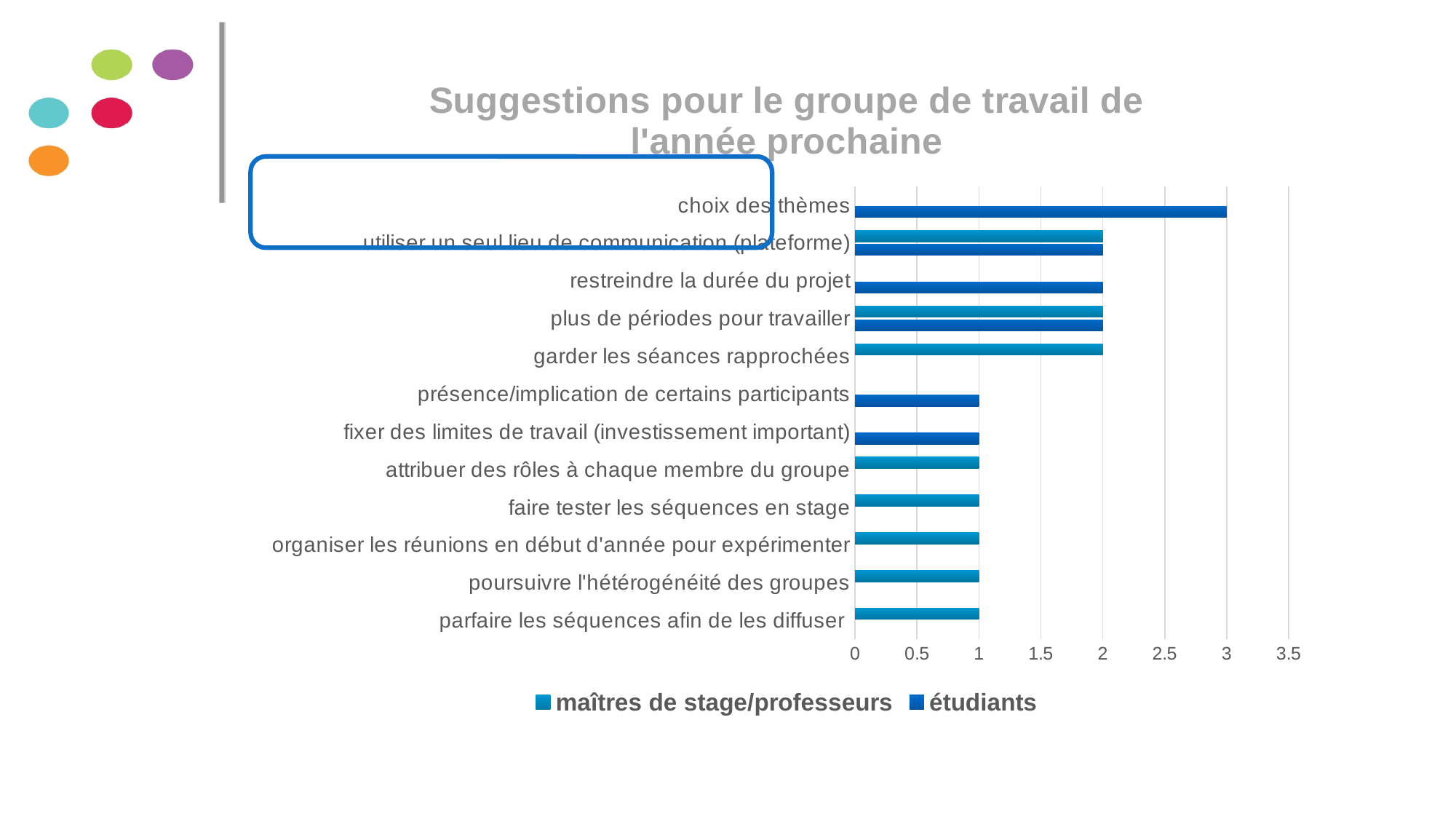
What is the value for 'garder les séances rapprochées' in the 'maîtres de stage/professeurs' series? 2 How many categories are plotted on the chart? 12 What is the difference between the 'étudiants' value for 'choix des thèmes' and the 'étudiants' value for 'fixer des limites de travail (investissement important)'? 2 What is the value for 'restreindre la durée du projet' in the 'étudiants' series? 2 What is the value for 'parfaire les séquences afin de les diffuser' in the 'maîtres de stage/professeurs' series? 1 What is the title of the chart? Suggestions pour le groupe de travail de l'année prochaine What is the value for 'choix des thèmes' in the 'étudiants' series? 3 What kind of chart is shown on the slide? bar chart Which is larger: the 'étudiants' value for 'choix des thèmes' or the 'étudiants' value for 'présence/implication de certains participants'? choix des thèmes Is the 'étudiants' value for 'choix des thèmes' greater or less than 2.5? greater Which category has the highest value for the 'étudiants' series? choix des thèmes How many series does the legend list? 2